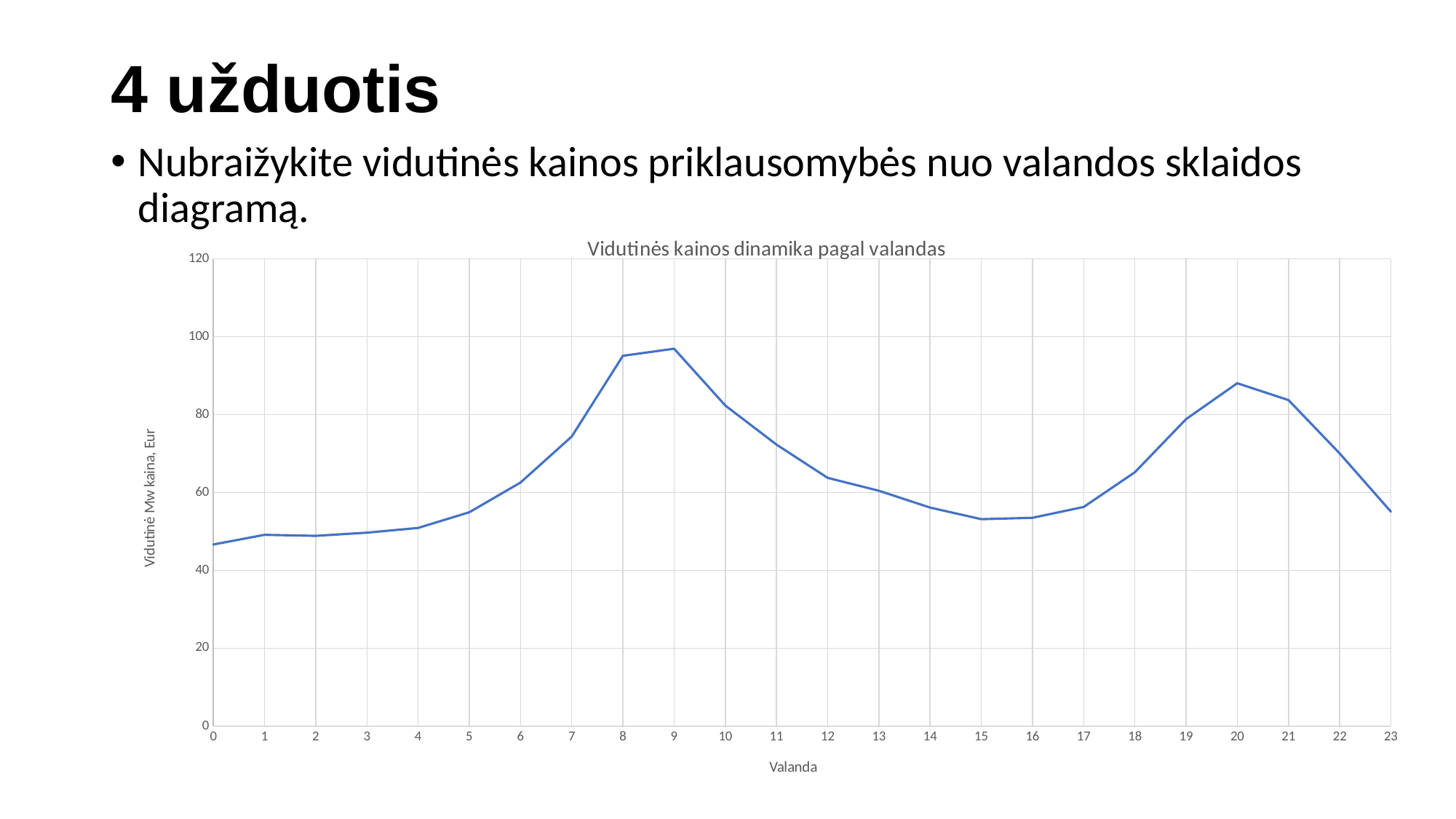
Which hour has the higher average price, hour 9 or hour 20? 9 What is the label of the vertical axis? Vidutinė Mw kaina, Eur Is the value at hour 15 greater or less than 60? less Is the value at hour 9 greater or less than 80? greater What is the title of the chart? Vidutinės kainos dinamika pagal valandas At which hour (Valanda) does the average price reach its highest value? 9 How many hours (data points) are plotted along the x axis? 24 Does the average price rise or fall between hour 9 and hour 15? Fall What kind of chart is shown on the slide? Line chart At which hour (Valanda) is the average price lowest? 0 Is the value at hour 0 greater or less than 60? less